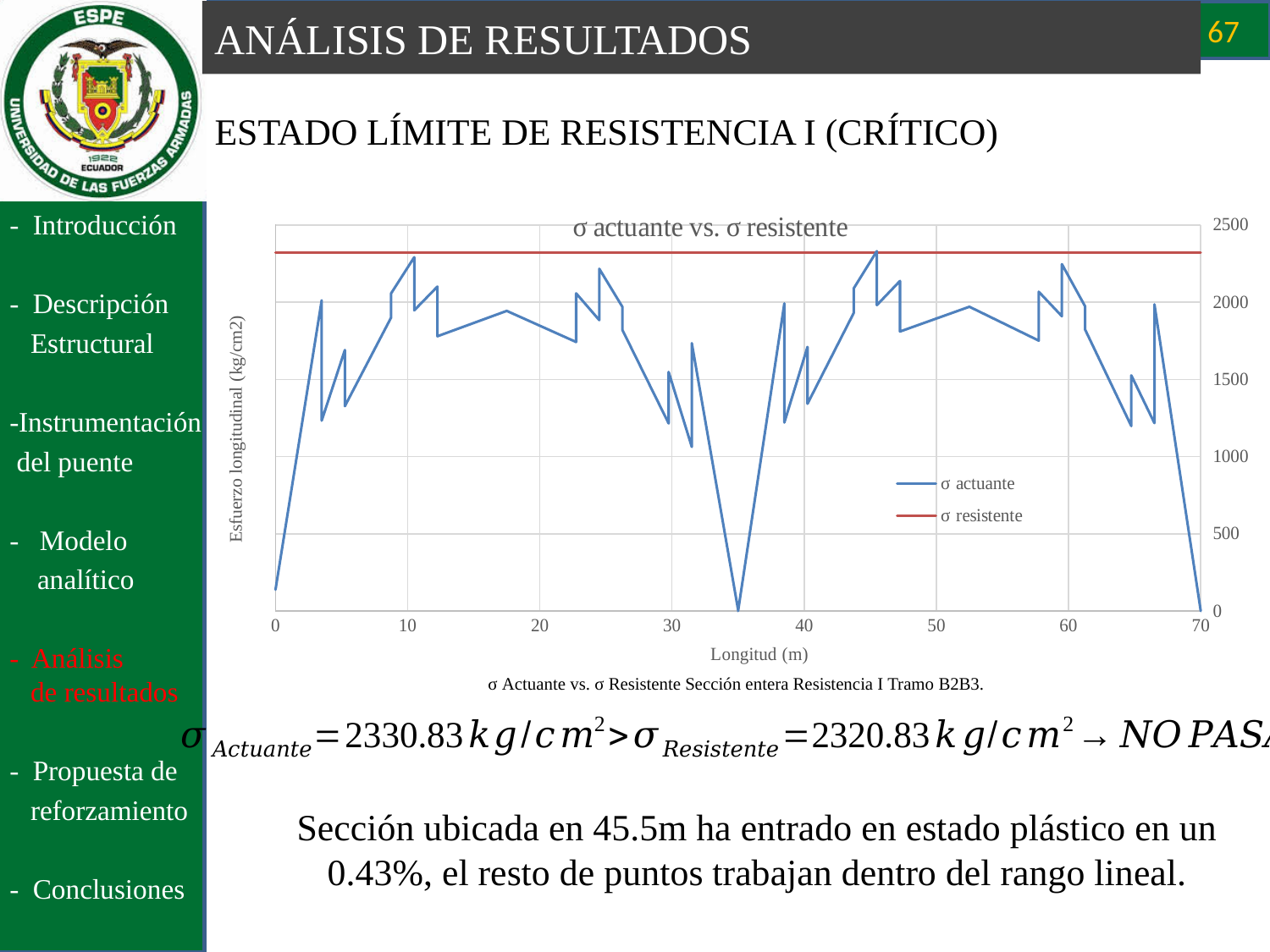
What is the label of the x axis of the chart? Longitud (m) How many series does the chart legend list? 2 Is the value of σ actuante at 10 m greater or less than 2000? greater Is the value of σ actuante at 35 m greater or less than 500? less What is the title of the chart? σ actuante vs. σ resistente At 20 m, which series has the higher value, σ actuante or σ resistente? σ resistente Is the value of σ actuante at 0 m greater or less than 500? less At 35 m, which series has the lower value, σ actuante or σ resistente? σ actuante What type of chart is shown on the slide? line chart Does the σ resistente line rise, fall, or stay constant along the x axis? stays constant